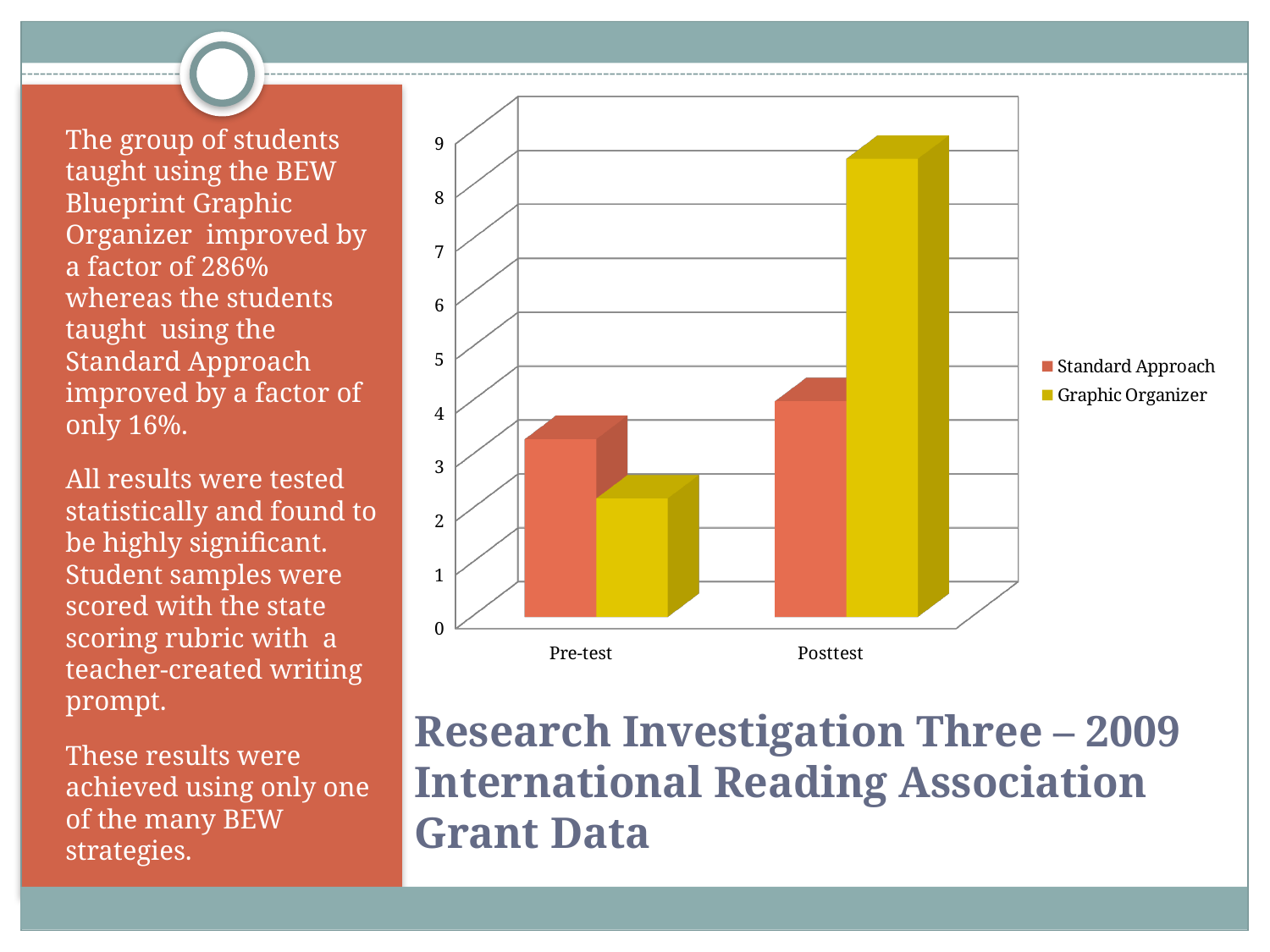
Which bar is the shortest in the chart? Graphic Organizer at Pre-test What kind of chart is shown on the slide? Bar chart At Pre-test, which series has the larger value, Standard Approach or Graphic Organizer? Standard Approach Which series is shown in yellow in the chart's legend? Graphic Organizer Does the Graphic Organizer value rise or fall from Pre-test to Posttest? rise Which series is shown in red/orange in the chart's legend? Standard Approach Is the Posttest value for Graphic Organizer greater or less than 8? greater How many series does the chart's legend list? 2 How many categories are shown on the x axis of the chart? 2 Is the Pre-test value for Graphic Organizer greater or less than 3? less Which bar is the tallest in the chart? Graphic Organizer at Posttest At Posttest, which series has the larger value, Standard Approach or Graphic Organizer? Graphic Organizer